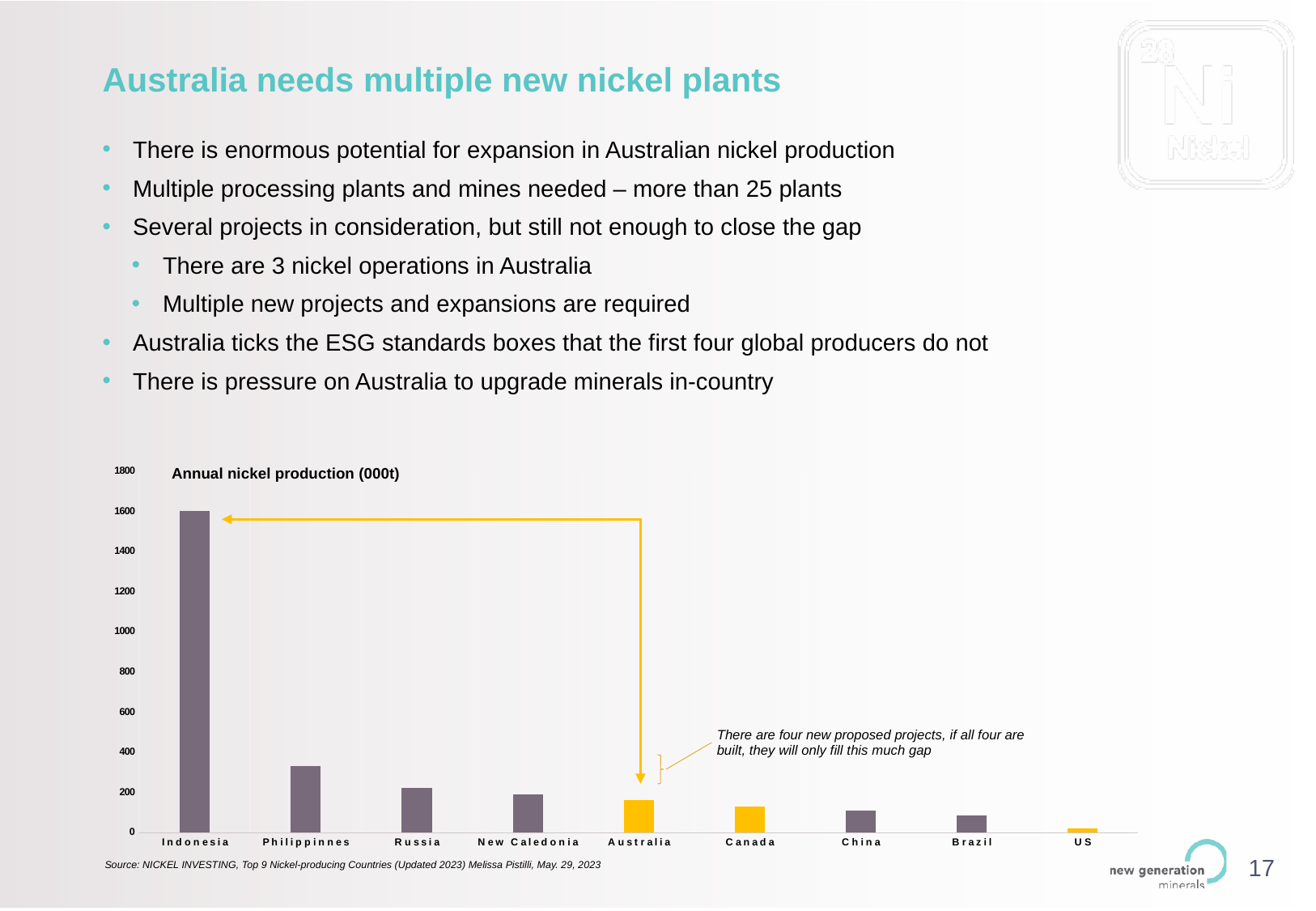
Is the value for Australia greater or less than 200? less Is the value for Indonesia greater or less than 1400? greater What is the title of the chart? Annual nickel production (000t) Which country has the lowest annual nickel production in the chart? US Is the value for Russia greater or less than 400? less Which has a larger annual nickel production, Russia or Brazil? Russia Do the bar values rise or fall moving from left to right along the x axis? fall Which country has the highest annual nickel production in the chart? Indonesia How many countries are shown on the x axis of the chart? 9 What kind of chart is shown on the slide? bar chart Which has a larger annual nickel production, Indonesia or Philippinnes? Indonesia